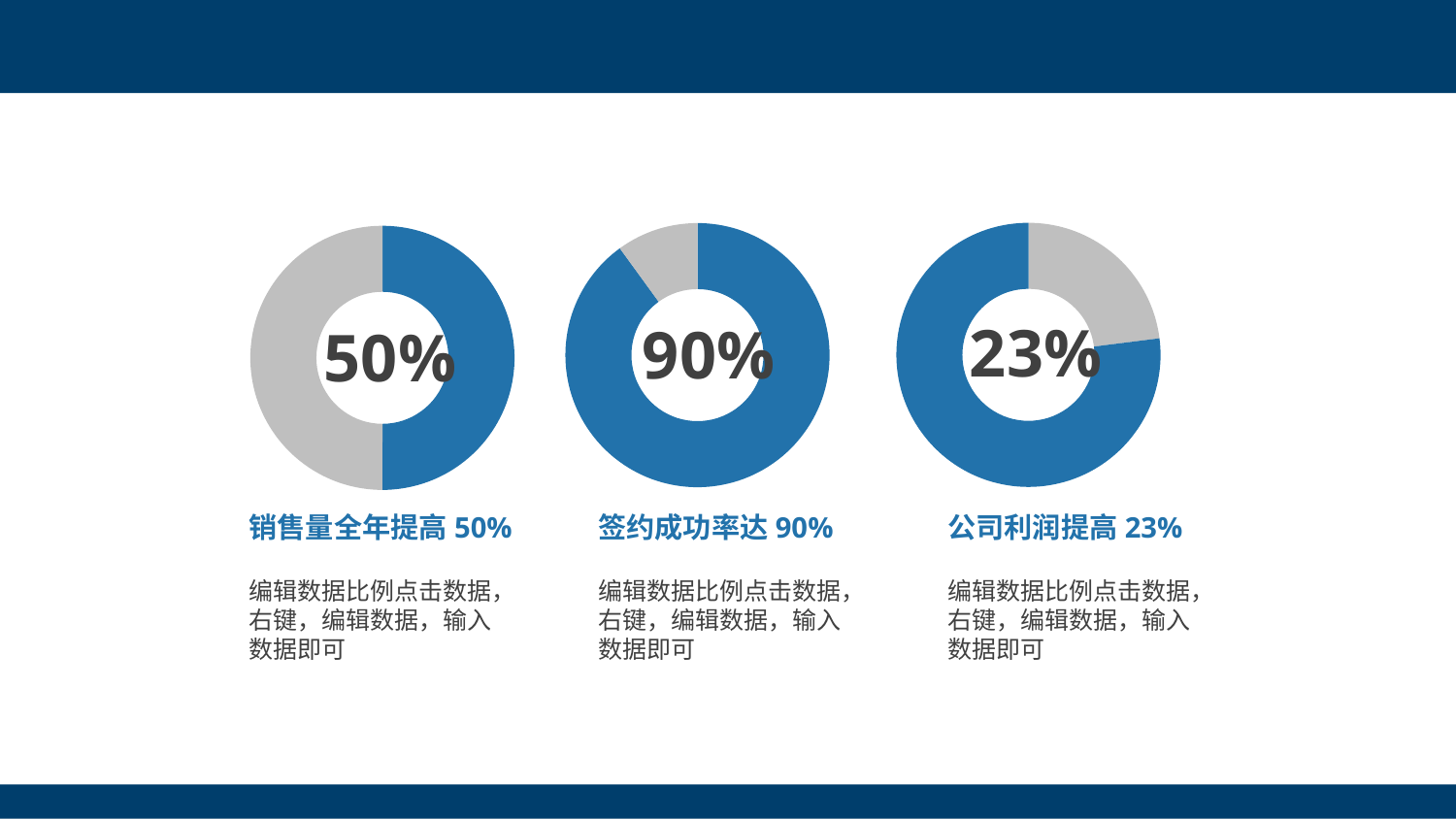
What percentage is shown in the centre of the right donut chart (公司利润提高)? 23% What is the difference between the percentage in the left chart (50%) and the percentage in the right chart (23%)? 27% Which is larger, the percentage in the left chart (销售量) or the percentage in the right chart (公司利润)? The left chart (销售量), 50% In the left donut chart, what colour is the filled 50% portion? Blue What percentage is shown in the centre of the left donut chart (销售量全年提高)? 50% Which of the three donut charts shows the lowest percentage? 公司利润提高 23% (right chart) What kind of chart is used for each of the three figures on the slide? Donut (pie) chart How many donut charts are on the slide? 3 Which of the three donut charts shows the highest percentage? 签约成功率达 90% (middle chart) What percentage is shown in the centre of the middle donut chart (签约成功率达)? 90% What is the caption under the middle donut chart? 签约成功率达 90% What is the difference between the percentage in the middle chart (90%) and the percentage in the left chart (50%)? 40%